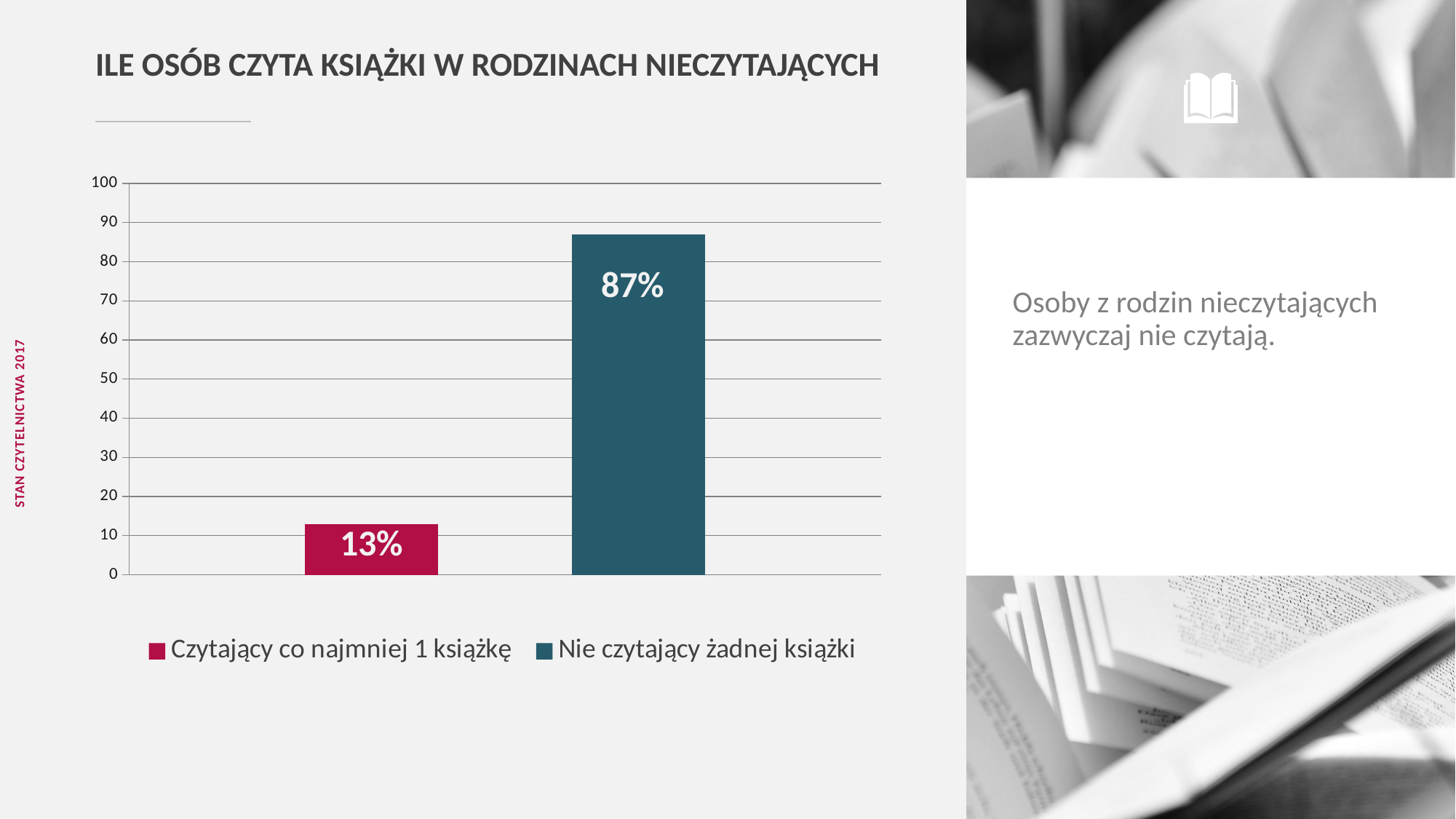
What is the value for "Czytający co najmniej 1 książkę"? 13% Which is larger: the value for "Czytający co najmniej 1 książkę" or for "Nie czytający żadnej książki"? Nie czytający żadnej książki What kind of chart is shown on the slide? bar chart How many series does the legend list? 2 Which series has the lowest value? Czytający co najmniej 1 książkę What is the difference between the values for "Nie czytający żadnej książki" and "Czytający co najmniej 1 książkę"? 74% What is the value for "Nie czytający żadnej książki"? 87% How many bars are plotted in the chart? 2 Is the value for "Czytający co najmniej 1 książkę" greater or less than 20? less What is the title of the chart? ILE OSÓB CZYTA KSIĄŻKI W RODZINACH NIECZYTAJĄCYCH Is the value for "Nie czytający żadnej książki" greater or less than 80? greater Which series has the highest value? Nie czytający żadnej książki